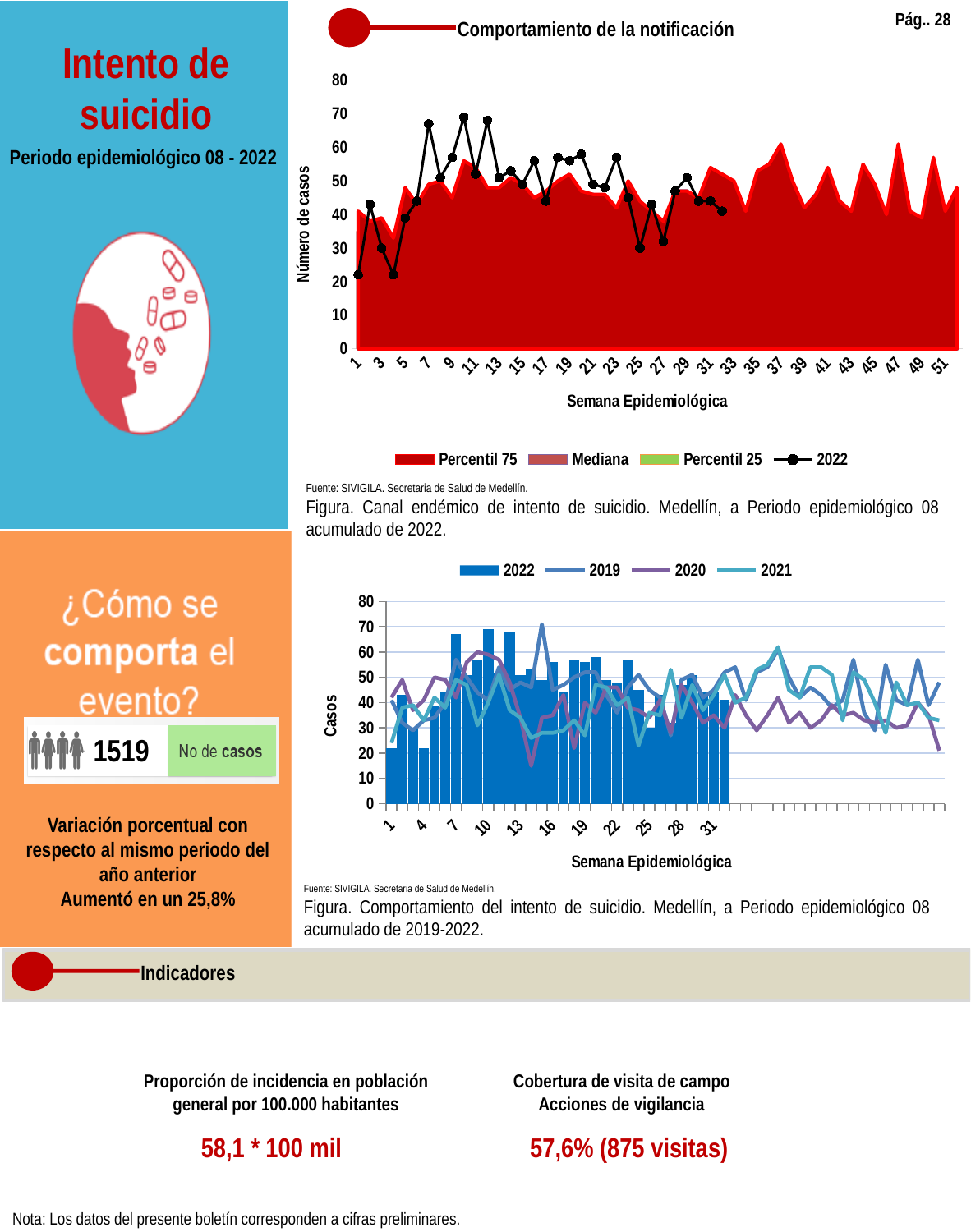
In the bottom chart (Comportamiento del intento de suicidio 2019-2022), is the 2022 bar for week 4 greater or less than 30? less In the bottom chart (Comportamiento del intento de suicidio 2019-2022), is the 2022 bar for week 10 greater or less than 60? greater In the top chart (Comportamiento de la notificación), which is larger for the 2022 series: week 7 or week 1? week 7 In the top chart (Comportamiento de la notificación), is the 2022 value for week 1 greater or less than 30? less In the top chart (Comportamiento de la notificación), how many series does the legend list? 4 In the top chart (Comportamiento de la notificación), what is the title of the vertical axis? Número de casos In the bottom chart (Comportamiento del intento de suicidio 2019-2022), how many series does the legend list? 4 In the bottom chart (Comportamiento del intento de suicidio 2019-2022), which 2022 bar is taller: week 10 or week 4? week 10 In the top chart (Comportamiento de la notificación), does the 2022 line generally rise or fall from week 1 to week 7? rise In the bottom chart (Comportamiento del intento de suicidio 2019-2022), which year is shown as bars rather than a line? 2022